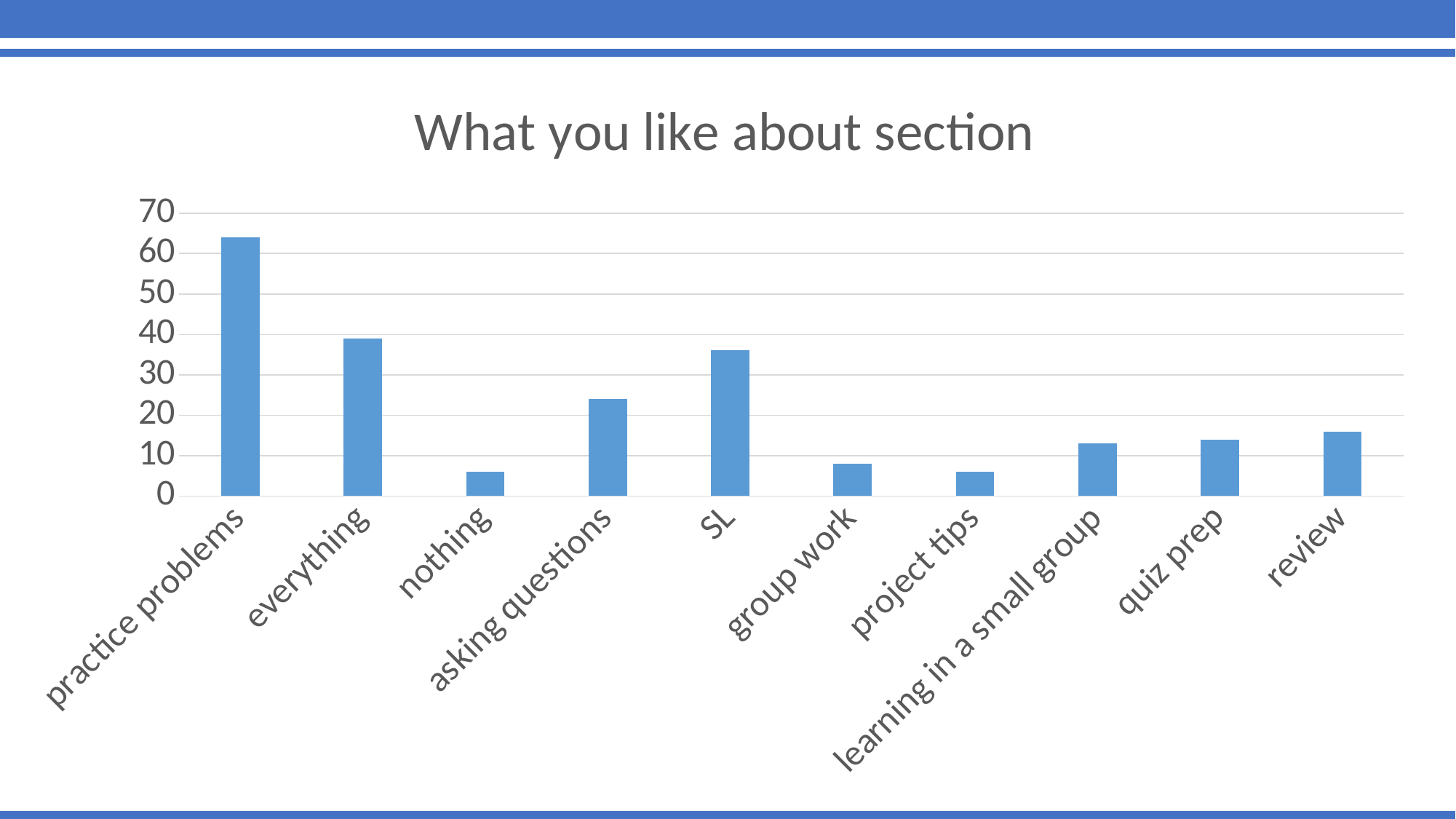
Which is larger, the value for asking questions or the value for SL? SL Is the value for asking questions greater or less than 20? greater Which category has the highest value in the chart? practice problems Is the value for everything greater or less than 30? greater Is the value for review greater or less than 20? less What is the title of the chart? What you like about section What kind of chart is shown on the slide? bar chart Which is larger, the value for practice problems or the value for everything? practice problems How many categories are shown on the x axis of the chart? 10